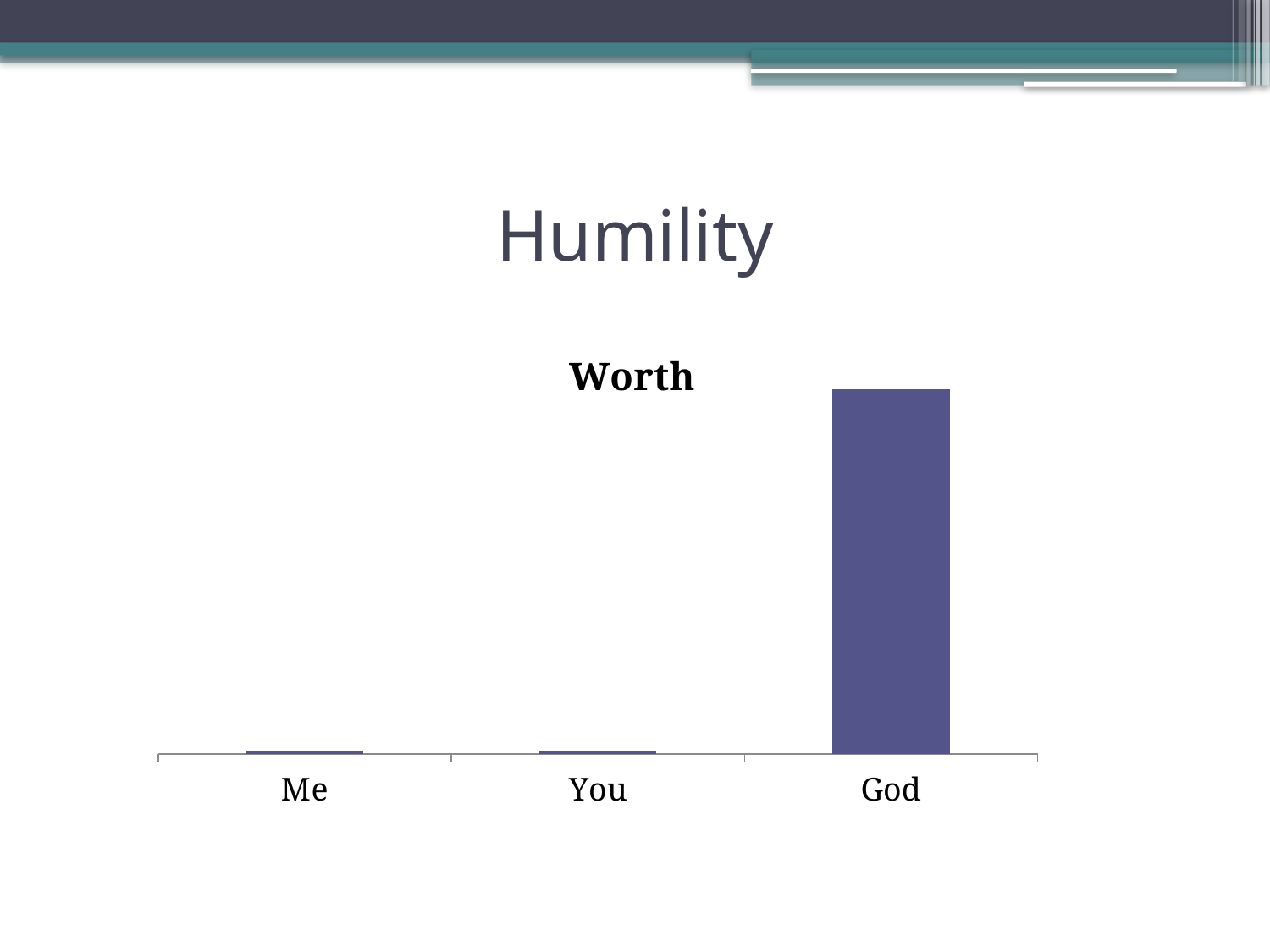
Which is larger, the value for God or the value for Me? God How many categories are shown on the x axis of the chart? 3 What are the category labels on the x axis, from left to right? Me, You, God Which is larger, the value for You or the value for God? God What kind of chart is shown on the slide? bar chart Which category has the highest value in the chart? God What is the title of the chart? Worth